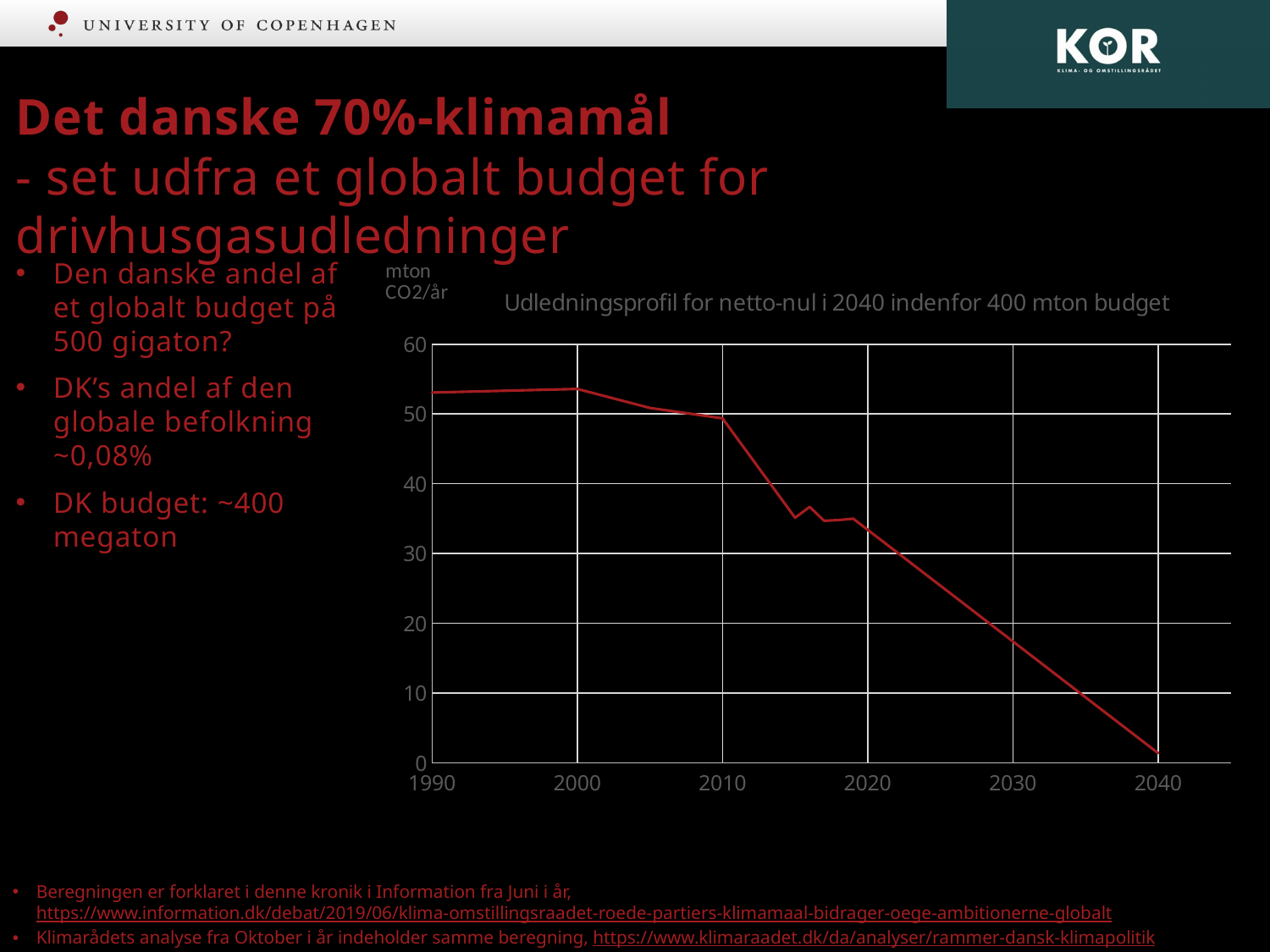
Is the value for 2030 greater or less than 20? less Is the value for 1990 greater or less than 50? greater Which year shown on the x axis has the lowest value? 2040 Is the value for 2040 greater or less than 10? less What unit is shown on the vertical axis of the chart? mton CO2/år Which is larger, the value for 2010 or the value for 2030? 2010 Do the values in the chart rise or fall from 1990 to 2040? fall What kind of chart is shown on the slide? line chart What is the title of the chart? Udledningsprofil for netto-nul i 2040 indenfor 400 mton budget Which is larger, the value for 1990 or the value for 2020? 1990